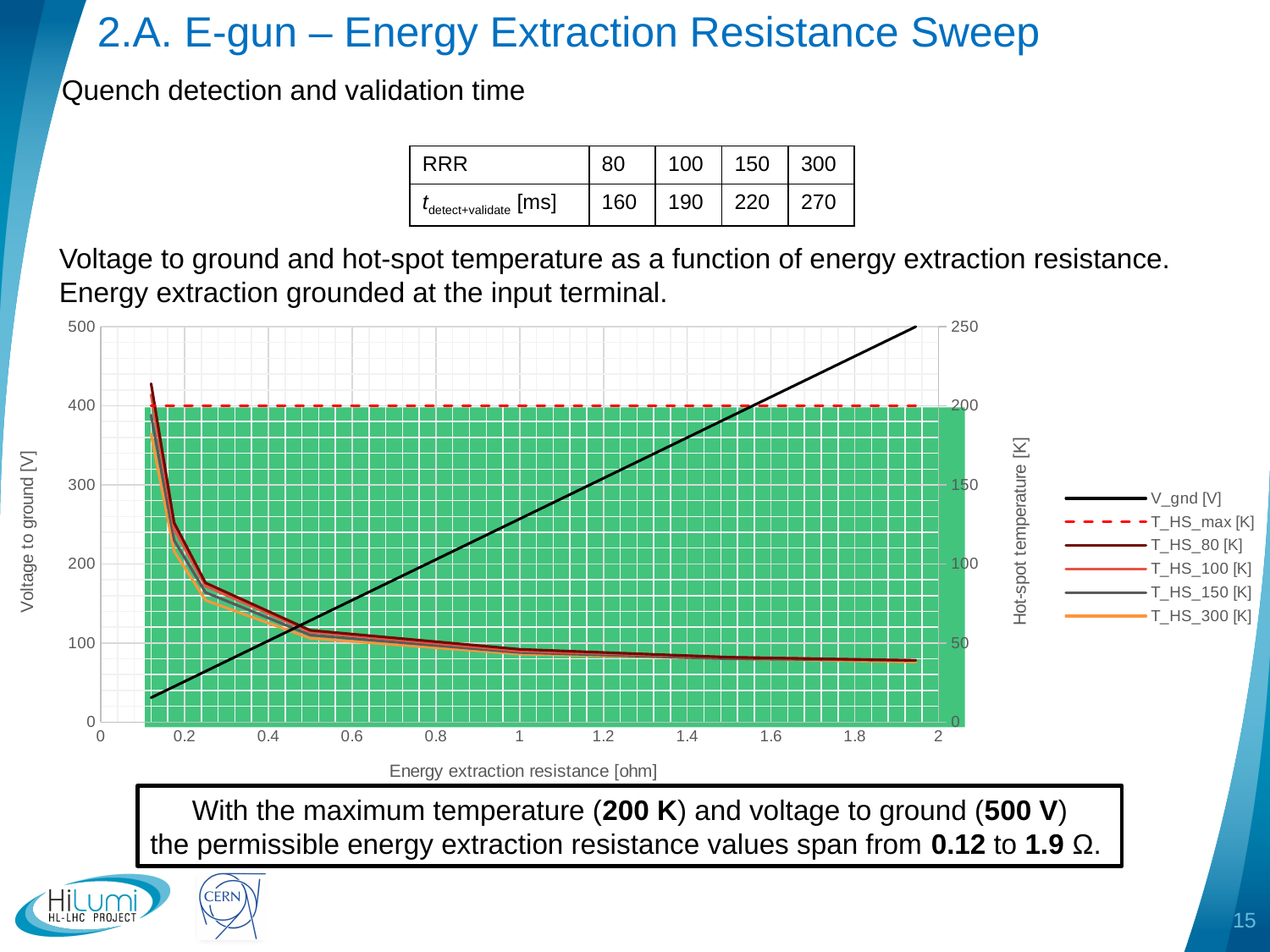
What is the title of the right-hand y axis of the chart? Hot-spot temperature [K] What is the title of the x axis of the chart? Energy extraction resistance [ohm] Is the value of V_gnd [V] at 1 ohm greater or less than 200? greater What kind of chart is shown on the slide? line chart Is the value of V_gnd [V] at 1.8 ohm greater or less than 400? greater Does T_HS_80 [K] rise or fall as the energy extraction resistance increases? fall Is the value of V_gnd [V] at 0.2 ohm greater or less than 100? less Does V_gnd [V] rise or fall as the energy extraction resistance increases? rise What constant value does the T_HS_max [K] line sit at on the right-hand axis? 200 How many series does the chart legend list? 6